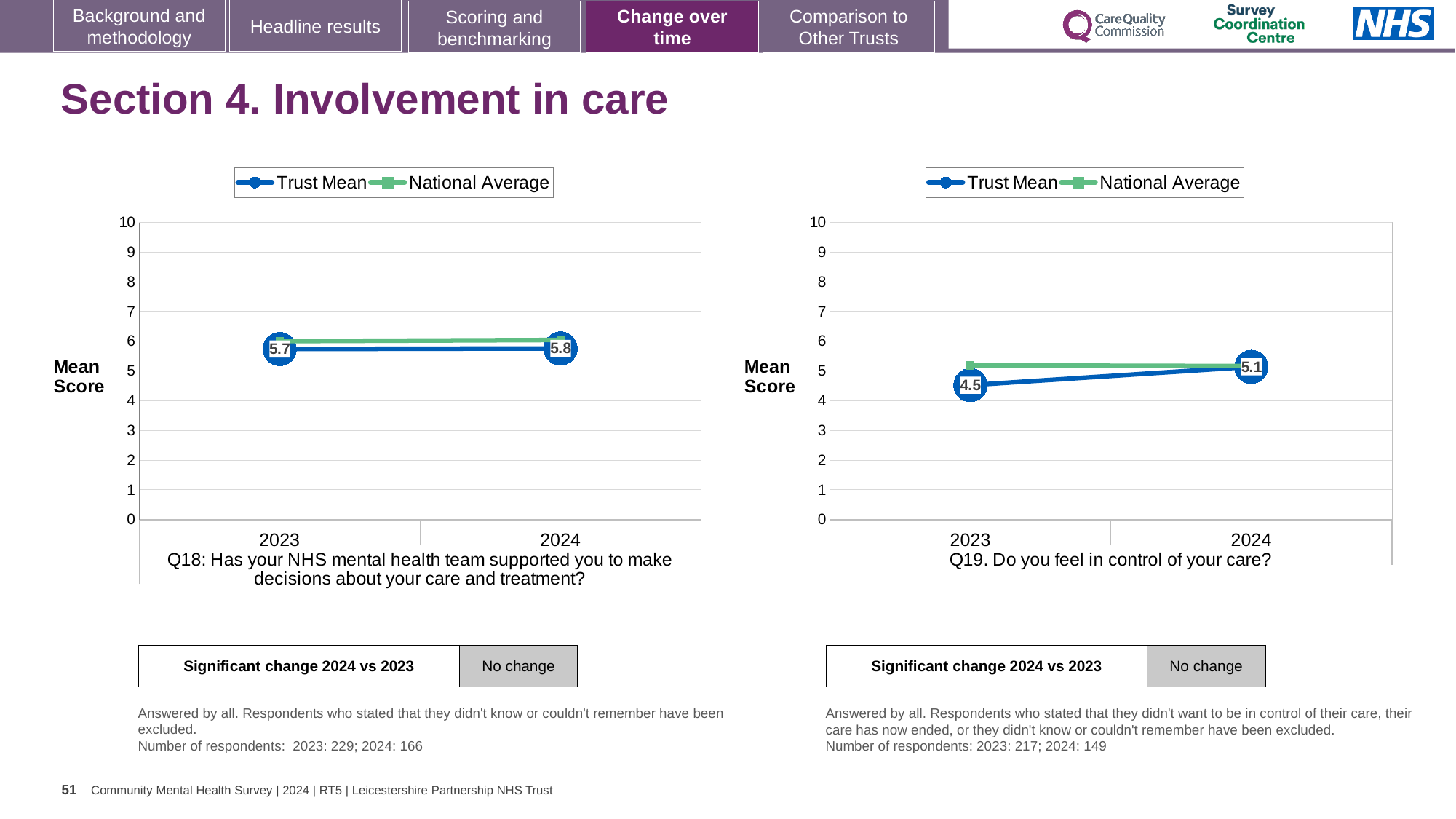
In the Q19 chart, does the Trust Mean rise or fall from 2023 to 2024? rise In the Q19 chart, what is the Trust Mean score for 2024? 5.1 How many years are plotted on the x axis of the Q19 chart? 2 In the Q19 chart, what is the Trust Mean score for 2023? 4.5 In the Q18 chart, what is the difference between the Trust Mean scores for 2024 and 2023? 0.1 In the Q18 chart, what is the Trust Mean score for 2024? 5.8 In the Q18 chart, what is the Trust Mean score for 2023? 5.7 In the Q19 chart, which year has the higher Trust Mean score, 2023 or 2024? 2024 What type of chart is used for Q19? line chart How many series does the legend of the Q18 chart list? 2 In the Q19 chart, by how much did the Trust Mean score change from 2023 to 2024? 0.6 In the Q18 chart, is the National Average value for 2024 greater or less than 5? greater